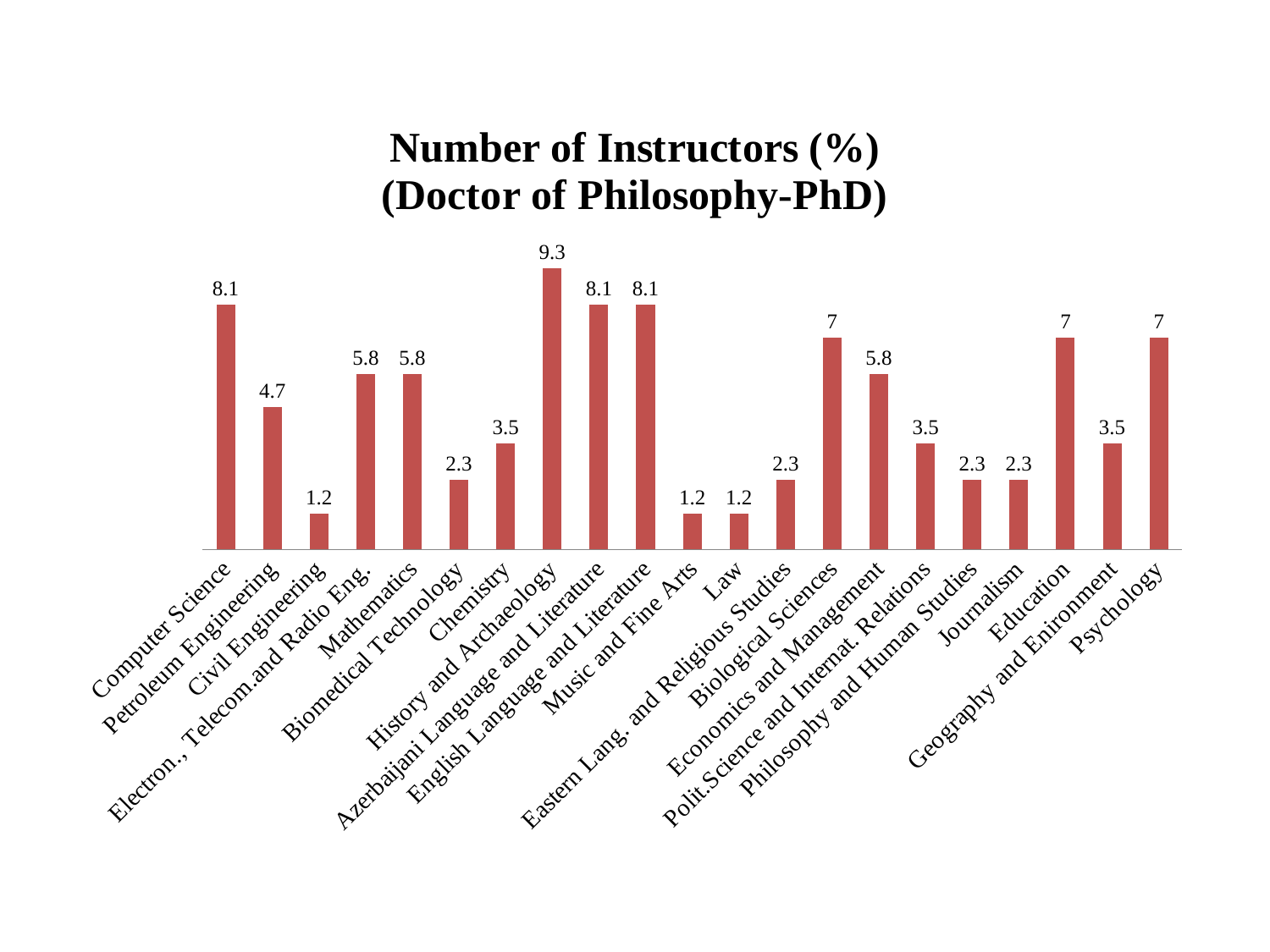
Which category has the highest value? History and Archaeology What is the difference between the values for Biological Sciences and Chemistry? 3.5 What is the value for History and Archaeology? 9.3 Which is larger, the value for Law or the value for Biomedical Technology? Biomedical Technology What is the difference between the values for History and Archaeology and Computer Science? 1.2 Which is larger, the value for Mathematics or the value for Psychology? Psychology What is the title of the chart? Number of Instructors (%) (Doctor of Philosophy-PhD) What is the value for Petroleum Engineering? 4.7 How many categories are shown in the chart? 21 What is the value for Journalism? 2.3 What kind of chart is shown on the slide? Bar chart What is the value for Economics and Management? 5.8